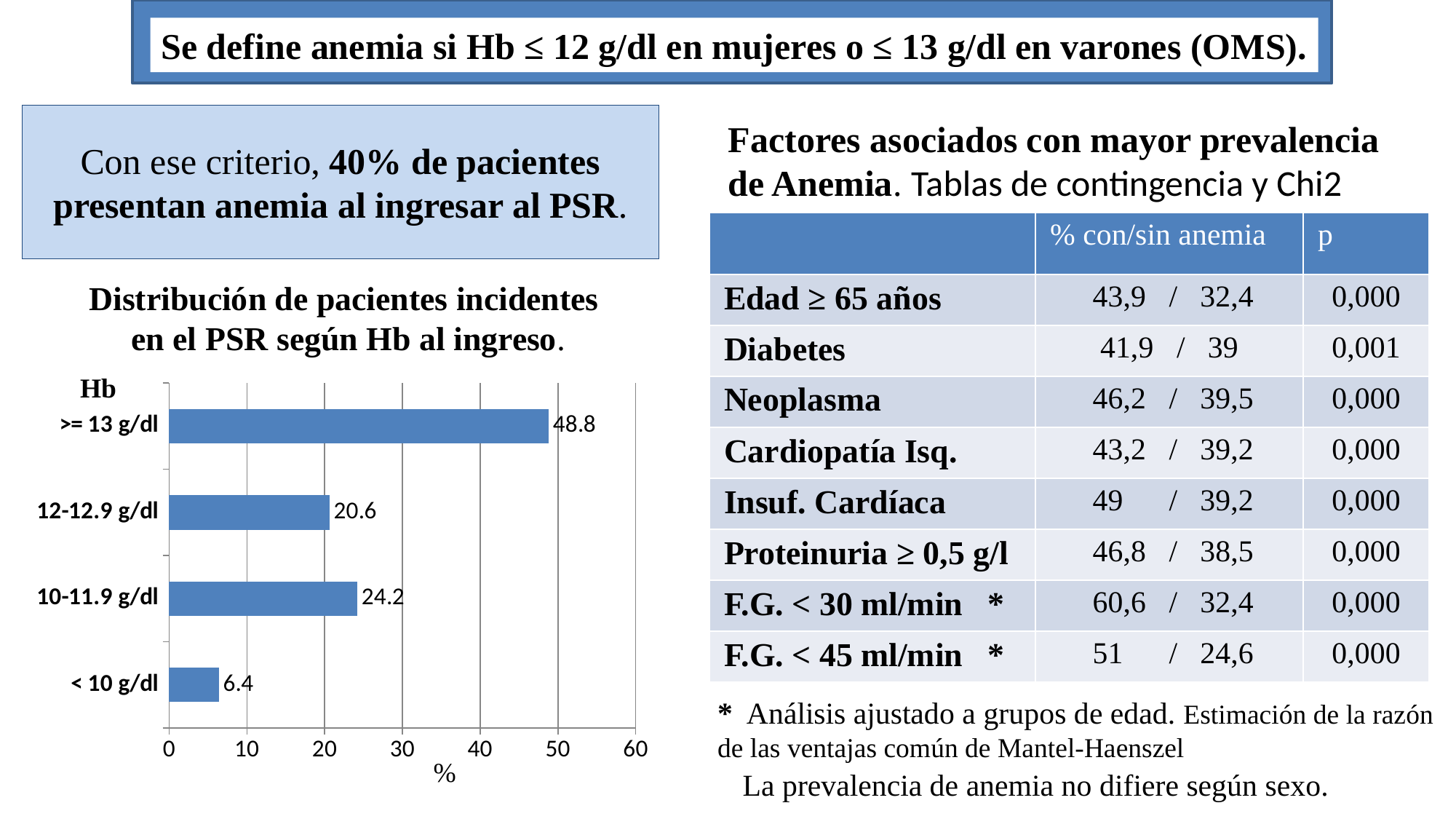
Which Hb category has the lowest value? < 10 g/dl What is the value for the 12-12.9 g/dl category? 20.6 What is the value for the >= 13 g/dl category? 48.8 What kind of chart is shown on the slide? bar chart Which Hb category has the highest value? >= 13 g/dl What is the difference between the values for >= 13 g/dl and 10-11.9 g/dl? 24.6 What is the value for the 10-11.9 g/dl category? 24.2 Which is larger, the value for 12-12.9 g/dl or the value for 10-11.9 g/dl? 10-11.9 g/dl Is the value for >= 13 g/dl greater or less than 40? greater How many Hb categories are shown in the chart? 4 What is the value for the < 10 g/dl category? 6.4 What is the title of the chart? Distribución de pacientes incidentes en el PSR según Hb al ingreso